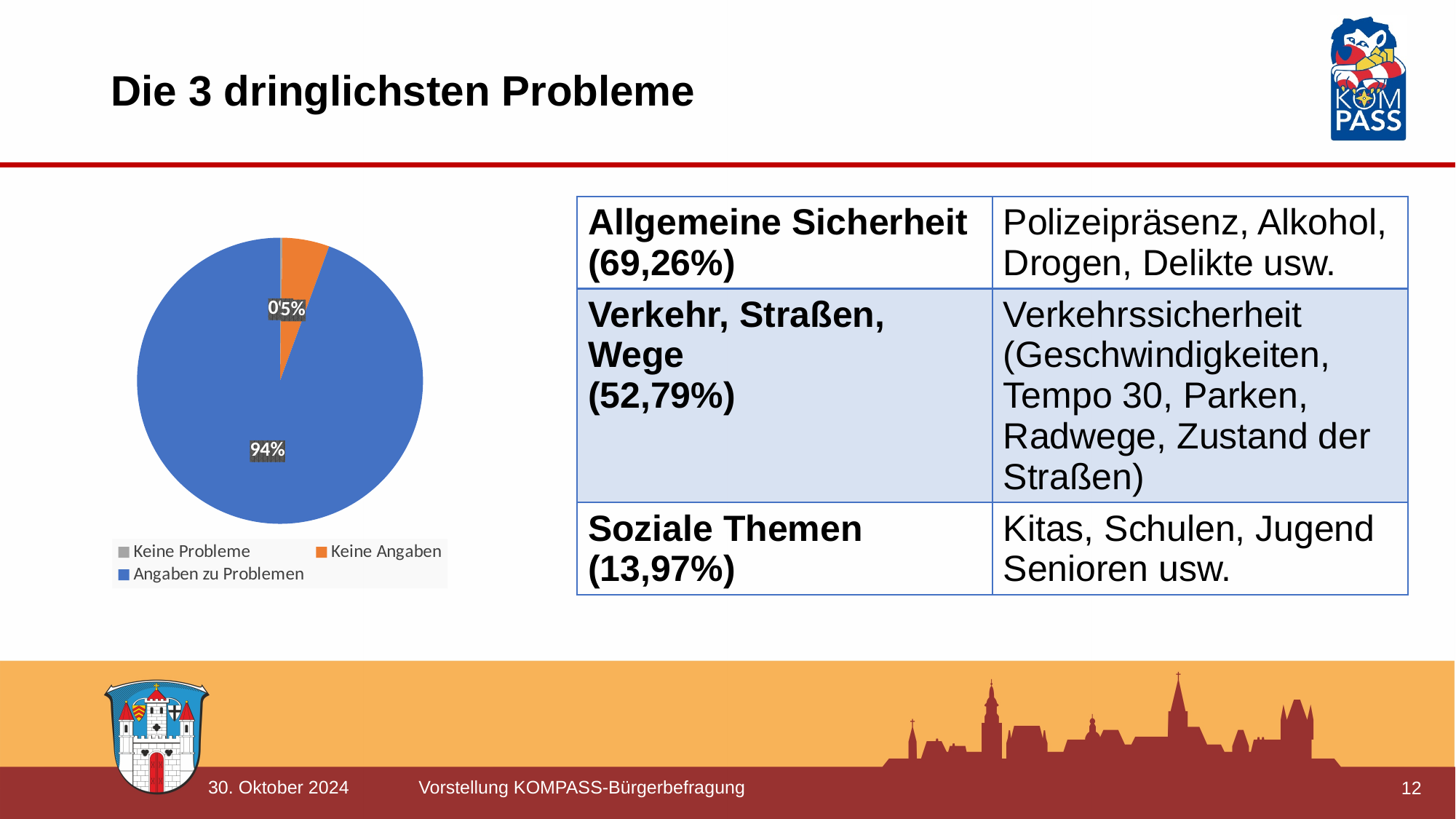
What colour is the "Keine Angaben" slice in the pie chart? orange Which slice is larger in the pie chart: "Keine Angaben" or "Angaben zu Problemen"? Angaben zu Problemen What kind of chart is shown on the slide? pie chart Which category has the smallest slice in the pie chart? Keine Probleme What percentage of the pie chart is labelled for "Keine Probleme"? 0% What percentage of the pie chart is labelled for "Keine Angaben"? 5% What is the difference in percentage points between the "Angaben zu Problemen" slice and the "Keine Angaben" slice? 89 What percentage of the pie chart is labelled for "Angaben zu Problemen"? 94% What colour is the "Angaben zu Problemen" slice in the pie chart? blue Which category has the largest slice in the pie chart? Angaben zu Problemen How many categories does the pie chart's legend list? 3